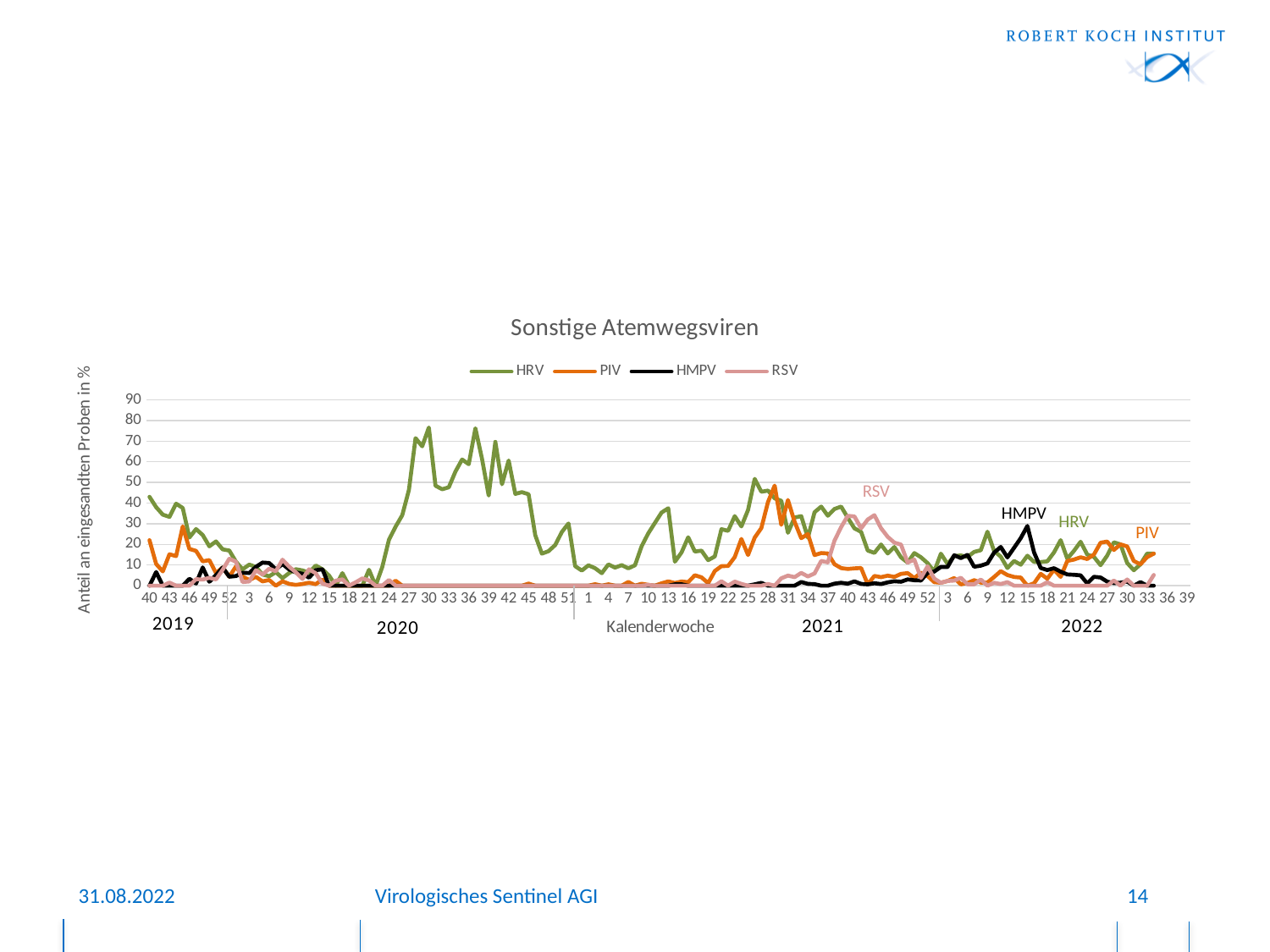
Is the highest value reached by PIV greater or less than 40? greater What is the title of the chart? Sonstige Atemwegsviren What is the label of the vertical axis? Anteil an eingesandten Proben in % Which series reaches a higher peak, HRV or RSV? HRV How many series does the legend list? 4 Is the highest value reached by RSV greater or less than 40? less Which series reaches a higher peak, PIV or HMPV? PIV Is the highest value reached by HMPV greater or less than 40? less What is the highest tick value shown on the vertical axis? 90 Which series reaches the highest value anywhere on the chart? HRV What kind of chart is shown on the slide? line chart